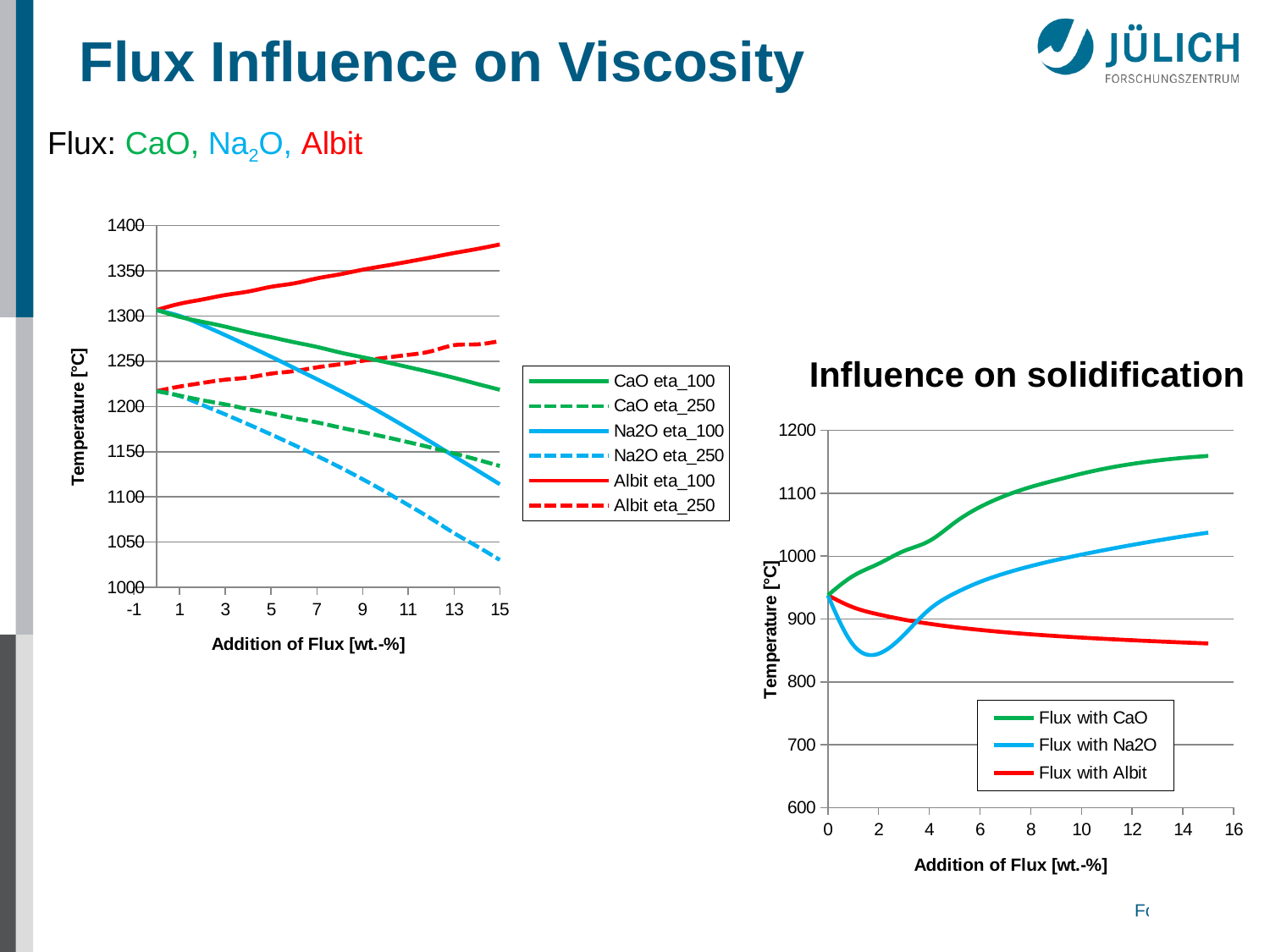
In the left chart, is the value of Na2O eta_250 at 15 wt.-% greater or less than 1050? less In the left chart, is the value of Albit eta_100 at 15 wt.-% greater or less than 1350? greater What kind of chart is the 'Influence on solidification' chart? line chart How many series does the legend of the 'Influence on solidification' chart list? 3 In the 'Influence on solidification' chart, is the value of Flux with Albit at 14 wt.-% greater or less than 900? less In the left chart, does the Albit eta_100 line rise or fall as the addition of flux increases? rise How many series does the legend of the left chart list? 6 What kind of chart is the left chart on the slide? line chart In the left chart, does the Na2O eta_250 line rise or fall as the addition of flux increases? fall In the 'Influence on solidification' chart, does the Flux with Albit line rise or fall as the addition of flux increases? fall What is the x-axis label of the 'Influence on solidification' chart? Addition of Flux [wt.-%]